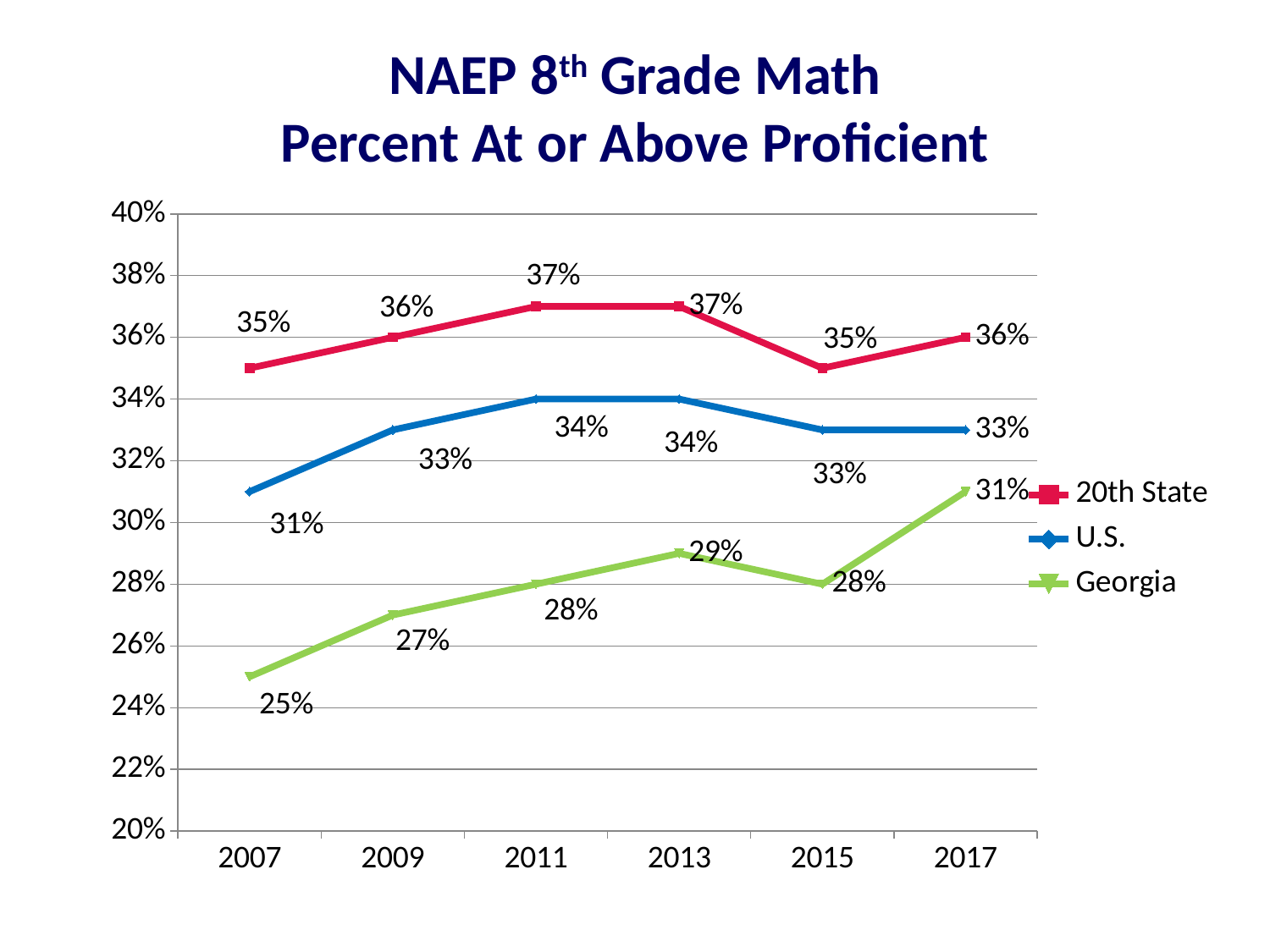
Which is larger in 2013: the U.S. value or the Georgia value? U.S. In which year is the Georgia value highest? 2017 What kind of chart is this? line chart What is the value for the 20th State series in 2011? 37% What is the value for Georgia in 2007? 25% How many years are shown on the x axis? 6 What is the difference between the 20th State value and the Georgia value in 2017? 5% Is the Georgia value in 2009 greater or less than 30%? less Does the Georgia value rise or fall from 2007 to 2013? rise In which year is the U.S. value lowest? 2007 What is the value for U.S. in 2015? 33% How many series does the legend list? 3